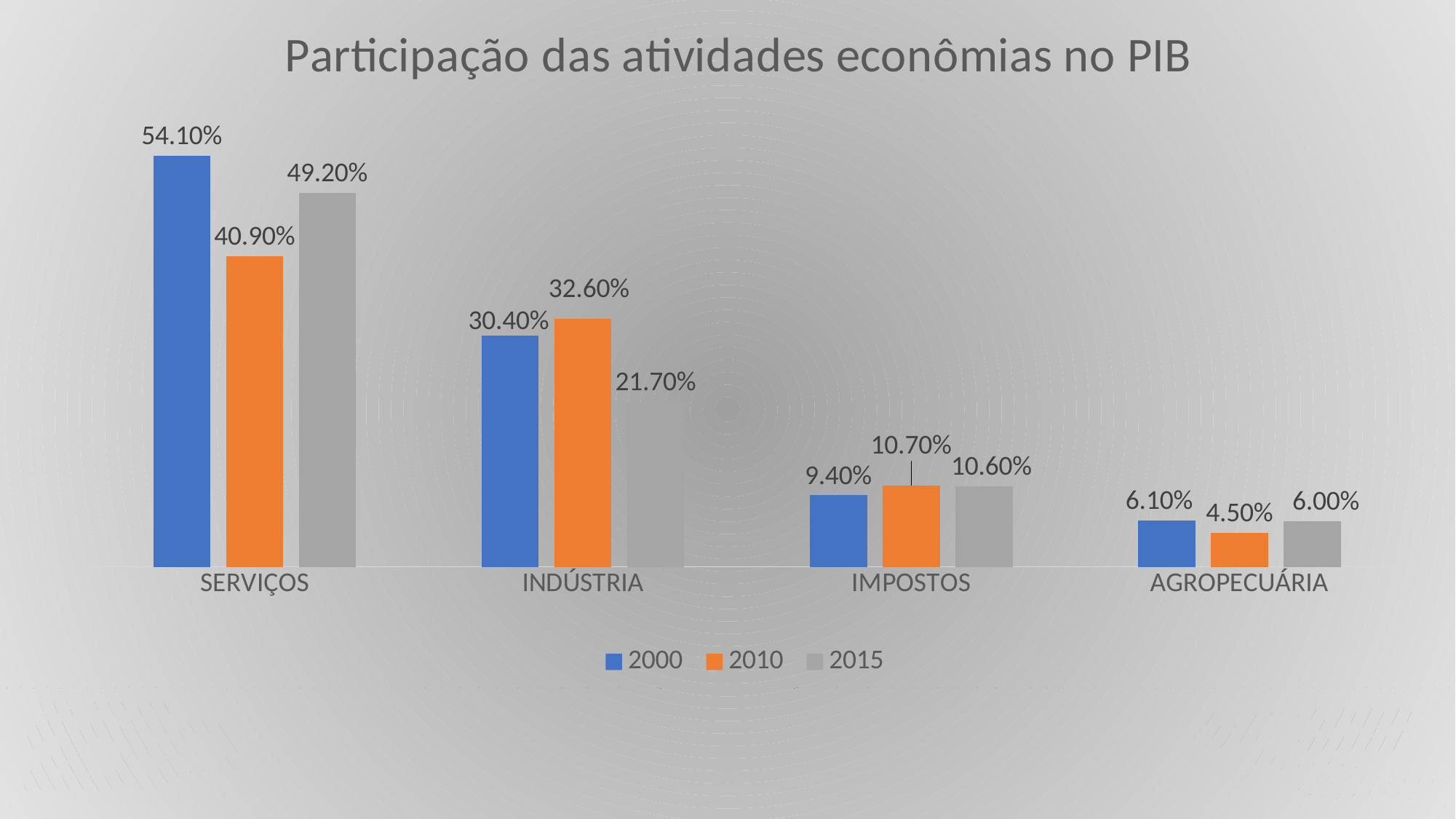
Which category has the highest value in 2015? SERVIÇOS What is the value for SERVIÇOS in 2000? 54.10% What is the difference between the 2000 and 2010 values for SERVIÇOS? 13.20% What kind of chart is shown? Bar chart What is the value for IMPOSTOS in 2010? 10.70% Which is larger for INDÚSTRIA: the 2000 value or the 2010 value? 2010 What is the value for AGROPECUÁRIA in 2010? 4.50% Which category has the lowest value in 2010? AGROPECUÁRIA How many series does the legend list? 3 How many categories are shown on the x axis? 4 What is the value for INDÚSTRIA in 2015? 21.70% What is the title of the chart? Participação das atividades econômias no PIB